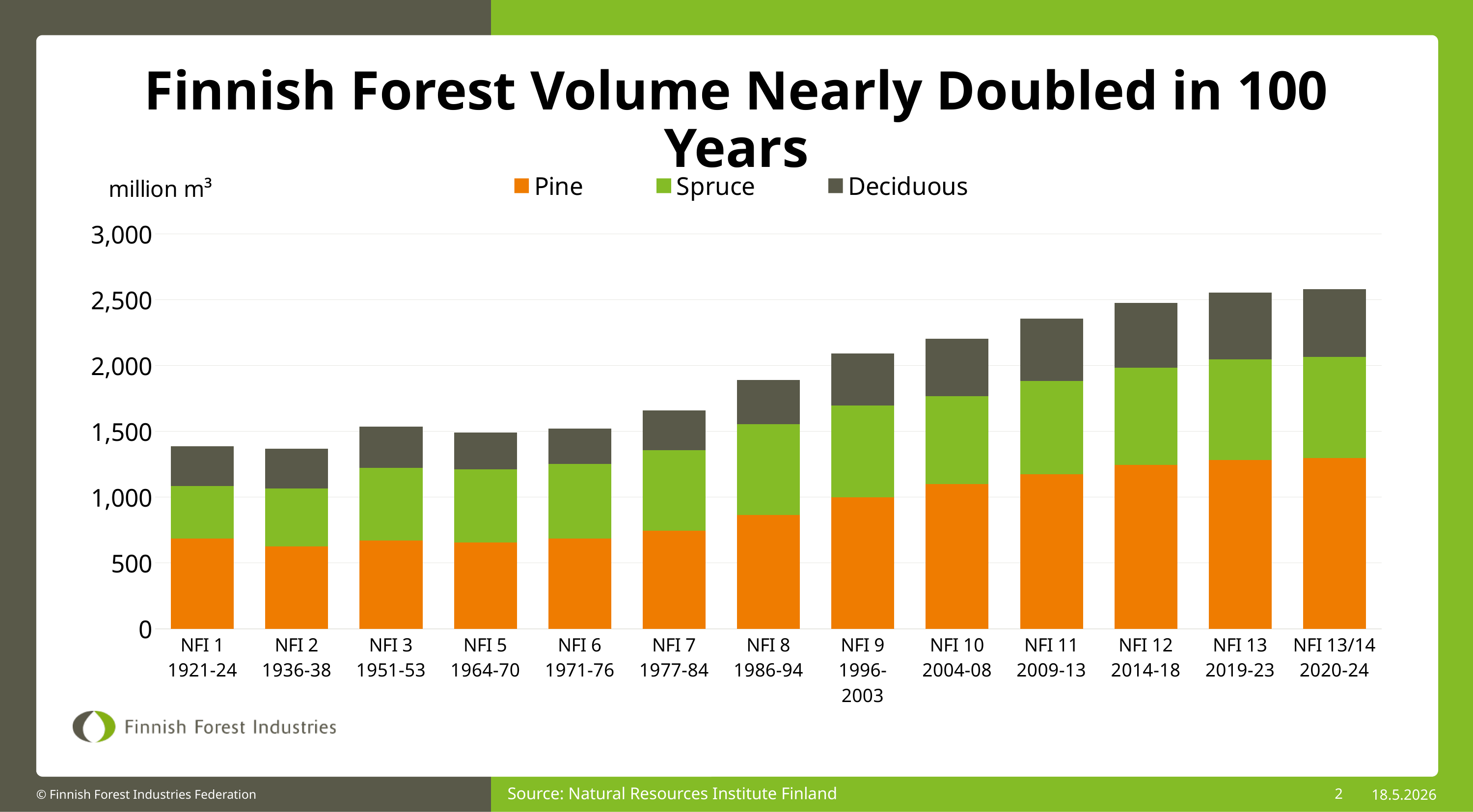
Which has the larger total volume, NFI 3 1951-53 or NFI 12 2014-18? NFI 12 2014-18 Is the total bar height for NFI 9 1996-2003 greater or less than 2,000? greater Do the total forest volumes generally rise or fall from NFI 1 to NFI 13/14? rise Is the total bar height for NFI 13/14 2020-24 greater or less than 2,500? greater What unit is shown for the y axis? million m³ Is the Pine value for NFI 8 1986-94 greater or less than 1,000? less How many series does the legend list? 3 How many bars (inventory periods) are plotted on the x axis? 13 Which has the larger Pine volume, NFI 1 1921-24 or NFI 9 1996-2003? NFI 9 1996-2003 What kind of chart is shown on the slide? stacked bar chart